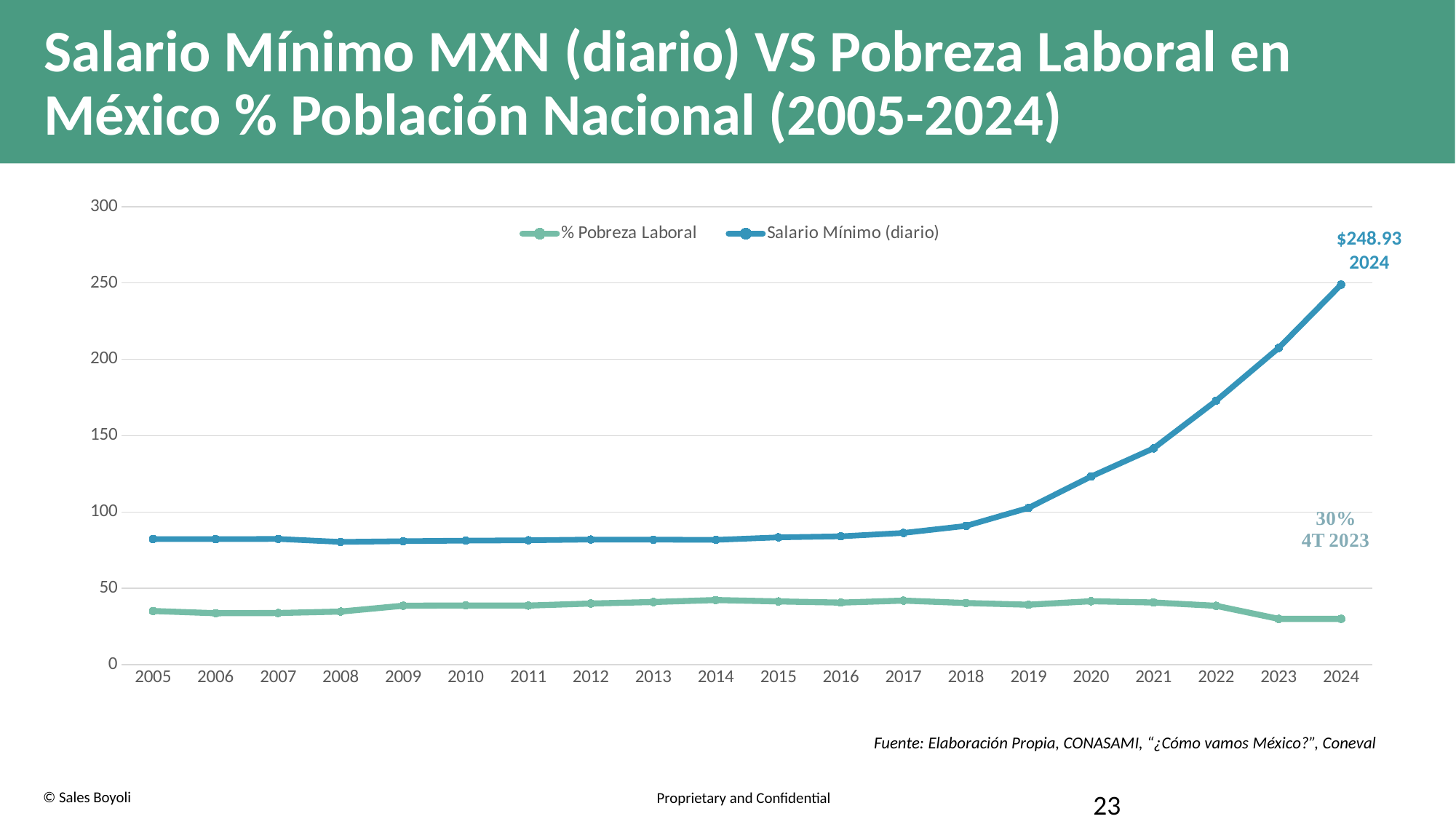
Is the value for Salario Mínimo (diario) in 2021 greater or less than 150? less How many series does the legend list? 2 How many years are plotted along the x axis? 20 Does Salario Mínimo (diario) rise or fall from 2018 to 2024? rise Which is larger: Salario Mínimo (diario) in 2022 or in 2021? 2022 What is the value of Salario Mínimo (diario) in 2024? $248.93 What value is labelled for % Pobreza Laboral at 4T 2023? 30% What kind of chart is shown on the slide? line chart Is the value for Salario Mínimo (diario) in 2020 greater or less than 100? greater In which year is Salario Mínimo (diario) highest? 2024 What are the two series named in the legend? % Pobreza Laboral and Salario Mínimo (diario) Is the value for % Pobreza Laboral in 2014 greater or less than 50? less